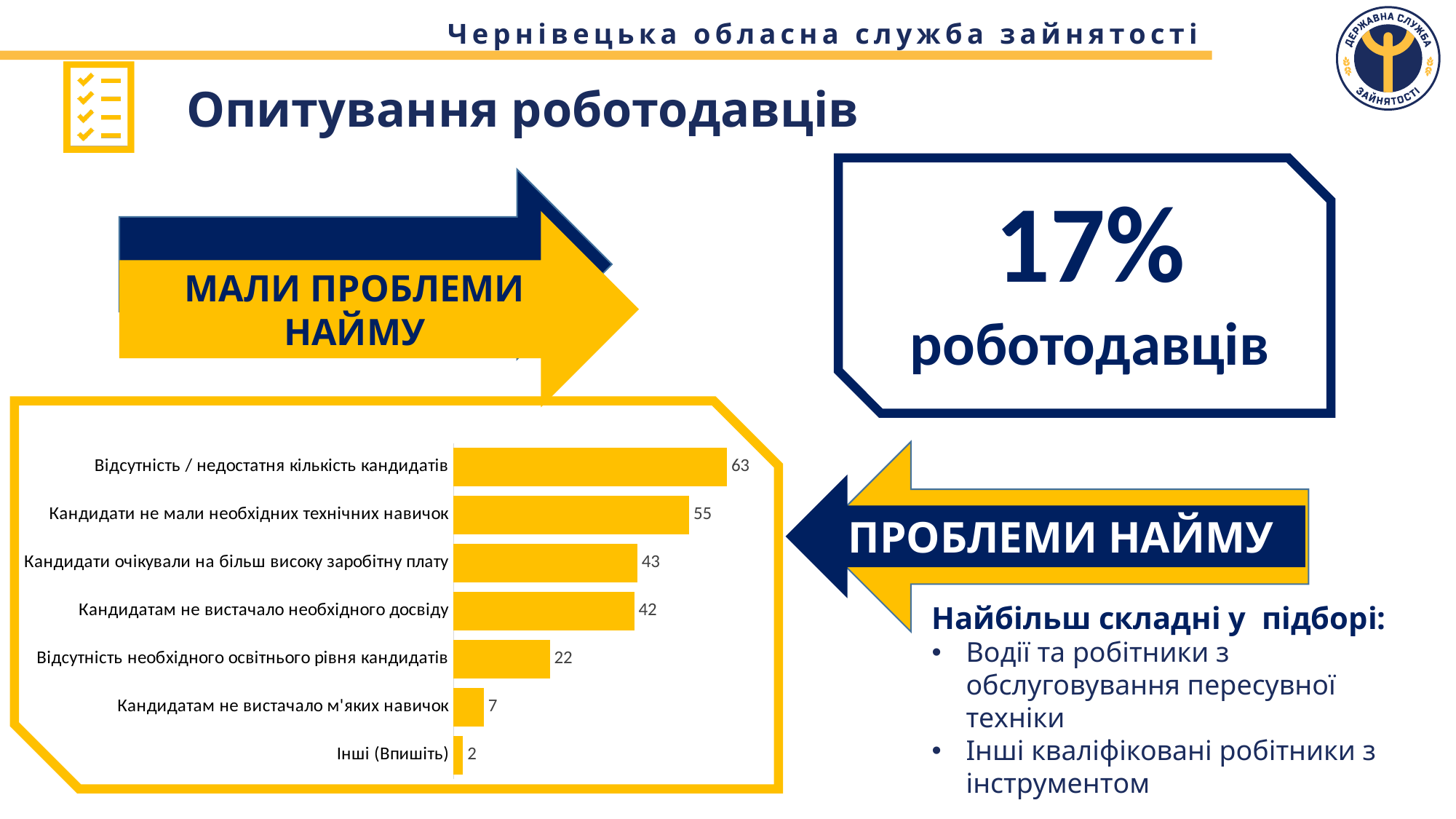
What is the value for "Кандидати не мали необхідних технічних навичок"? 55 How many categories are shown in the bar chart? 7 Which category has the highest value? Відсутність / недостатня кількість кандидатів Which is larger: the value for "Кандидатам не вистачало необхідного досвіду" or the value for "Відсутність необхідного освітнього рівня кандидатів"? Кандидатам не вистачало необхідного досвіду What is the value for "Відсутність / недостатня кількість кандидатів"? 63 What is the value for "Інші (Впишіть)"? 2 What is the difference between the values for "Відсутність / недостатня кількість кандидатів" and "Кандидати не мали необхідних технічних навичок"? 8 What colour are the bars in the chart? Yellow What is the value for "Кандидатам не вистачало м'яких навичок"? 7 Which category has the lowest value? Інші (Впишіть) What kind of chart is shown on the slide? Bar chart What is the difference between the values for "Кандидати очікували на більш високу заробітну плату" and "Відсутність необхідного освітнього рівня кандидатів"? 21